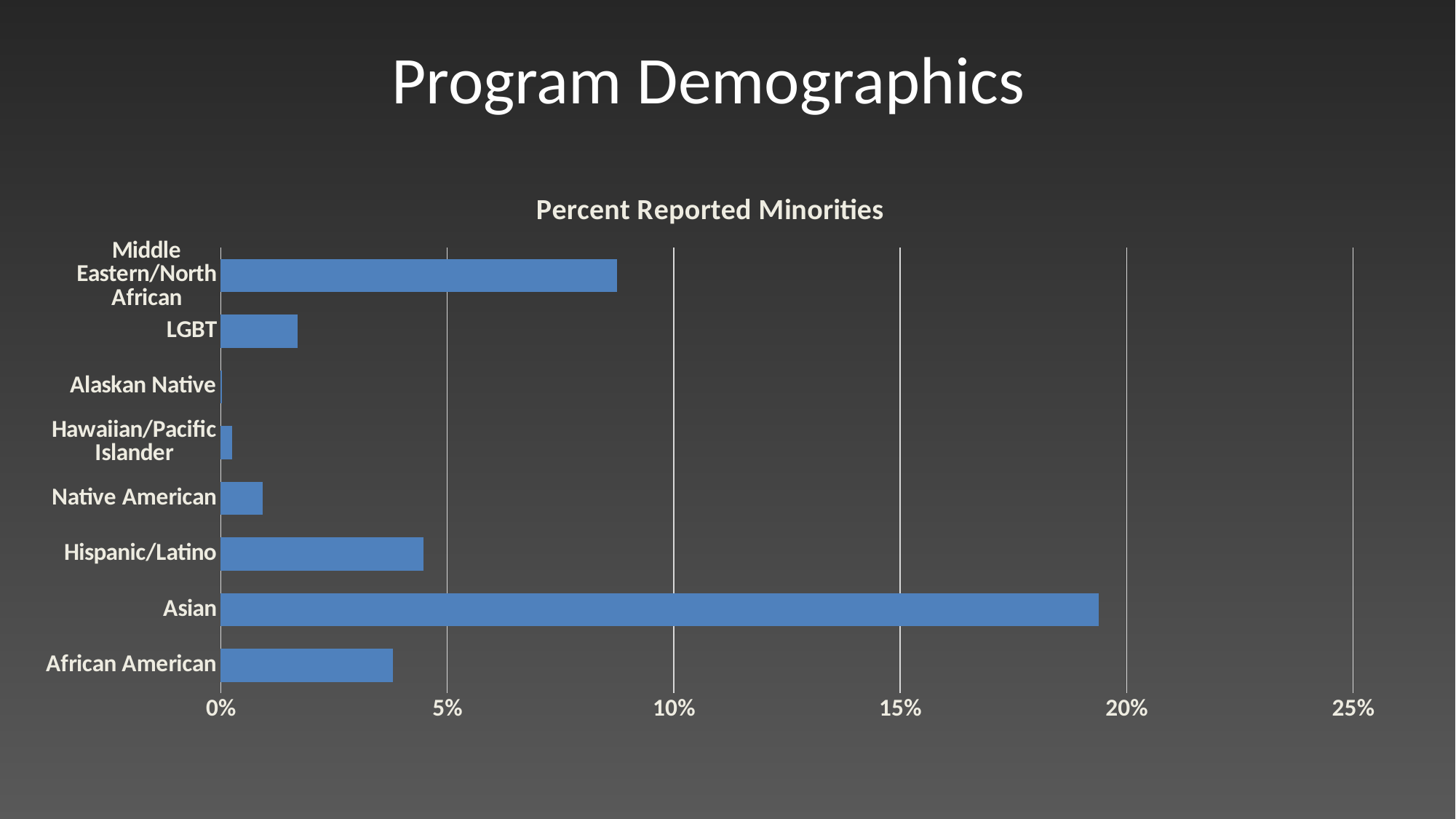
Which is larger, the value for LGBT or the value for Native American? LGBT What is the highest value shown on the horizontal axis? 25% Which category has the highest percentage? Asian What is the title of the chart? Percent Reported Minorities How many categories are plotted in the chart? 8 Is the value for Hispanic/Latino greater or less than 5%? less Is the value for Asian greater or less than 15%? greater Which category has the lowest percentage? Alaskan Native Which is larger, the value for Hispanic/Latino or the value for African American? Hispanic/Latino Is the value for Middle Eastern/North African greater or less than 10%? less What kind of chart is shown on the slide? bar chart